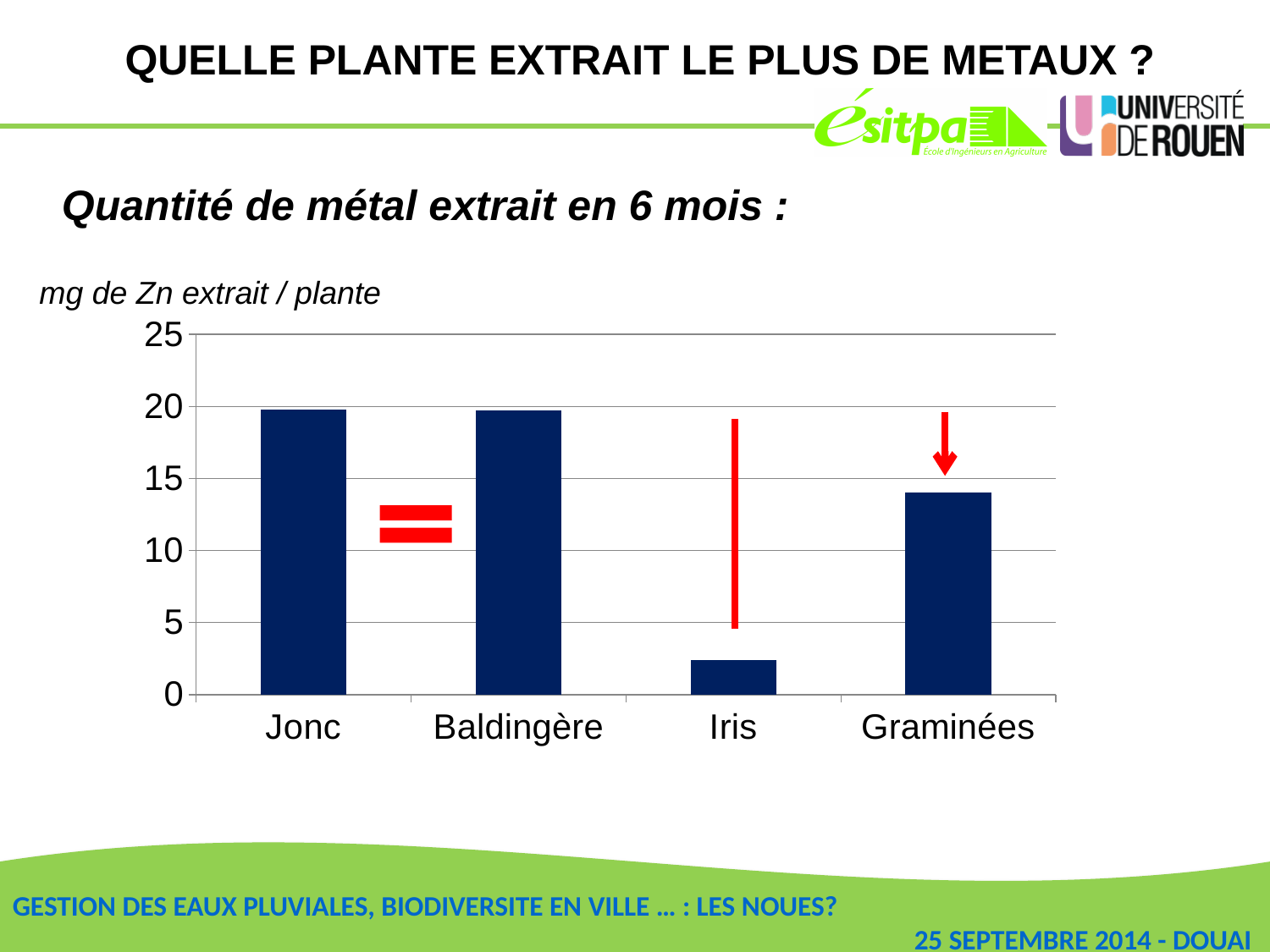
What unit label is written above the y axis of the chart? mg de Zn extrait / plante What kind of chart is shown on the slide? bar chart Is the value for Jonc greater or less than 15? greater Which has a larger value, Jonc or Iris? Jonc Which plant has the lowest amount of Zn extracted? Iris How many plant categories are shown on the x axis of the chart? 4 Is the value for Graminées greater or less than 10? greater Is the value for Graminées greater or less than 15? less Which has a larger value, Iris or Graminées? Graminées Which has a larger value, Baldingère or Graminées? Baldingère